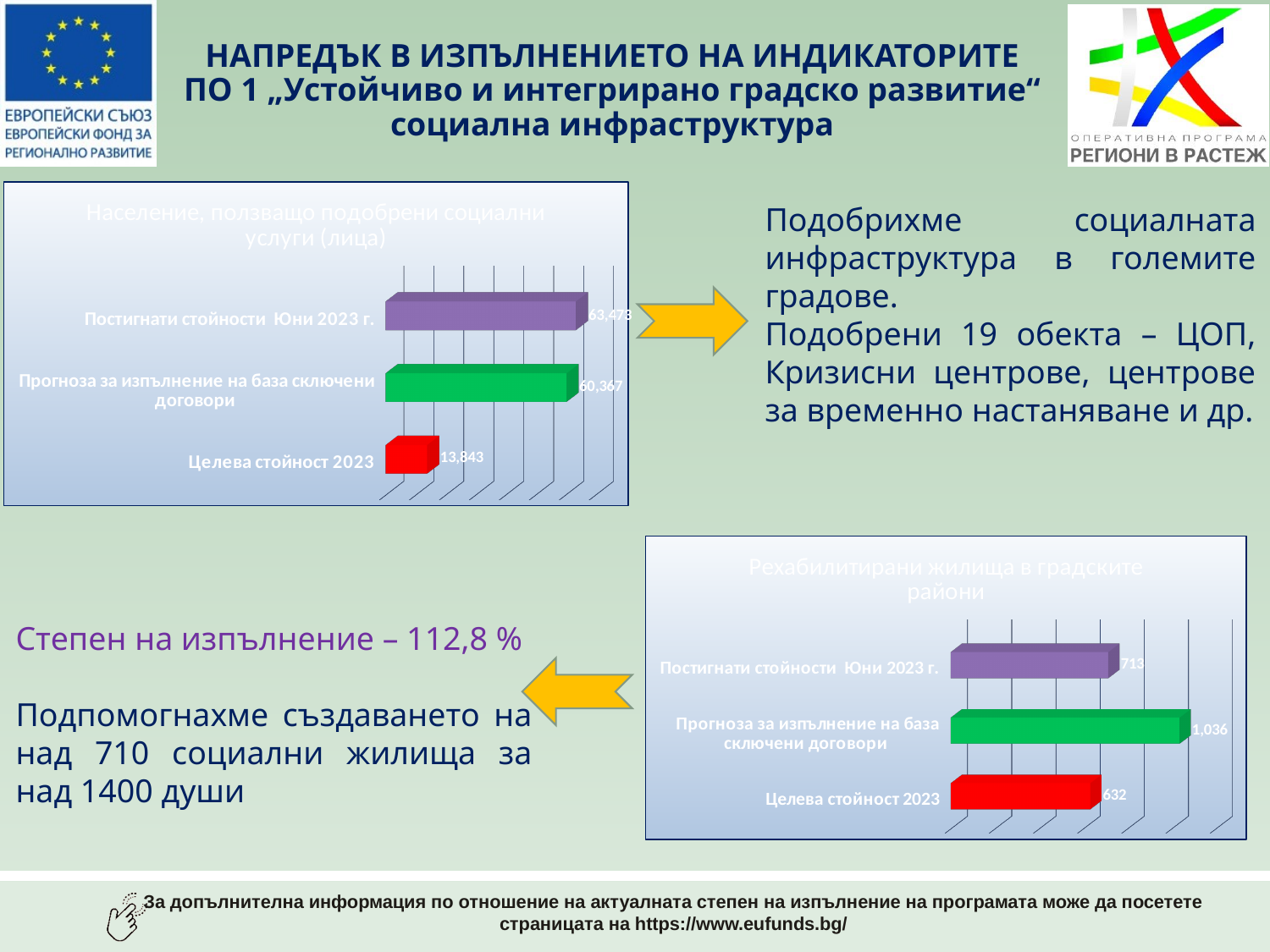
In the bottom-right chart, which category has the highest value? Прогноза за изпълнение на база сключени договори What kind of chart is the top-left chart? Bar chart How many categories does the bottom-right chart show? 3 In the bottom-right chart, what is the value for "Прогноза за изпълнение на база сключени договори"? 1,036 In the bottom-right chart, which is larger: "Постигнати стойности Юни 2023 г." or "Целева стойност 2023"? Постигнати стойности Юни 2023 г. In the top-left chart, what is the difference between "Постигнати стойности Юни 2023 г." and "Целева стойност 2023"? 49,630 In the top-left chart, which category has the lowest value? Целева стойност 2023 In the top-left chart, what is the value for "Прогноза за изпълнение на база сключени договори"? 60,367 In the bottom-right chart, what is the value for "Постигнати стойности Юни 2023 г."? 713 In the top-left chart, what is the value for "Постигнати стойности Юни 2023 г."? 63,473 In the top-left chart, what is the value for "Целева стойност 2023"? 13,843 In the bottom-right chart, what is the difference between "Постигнати стойности Юни 2023 г." and "Целева стойност 2023"? 81